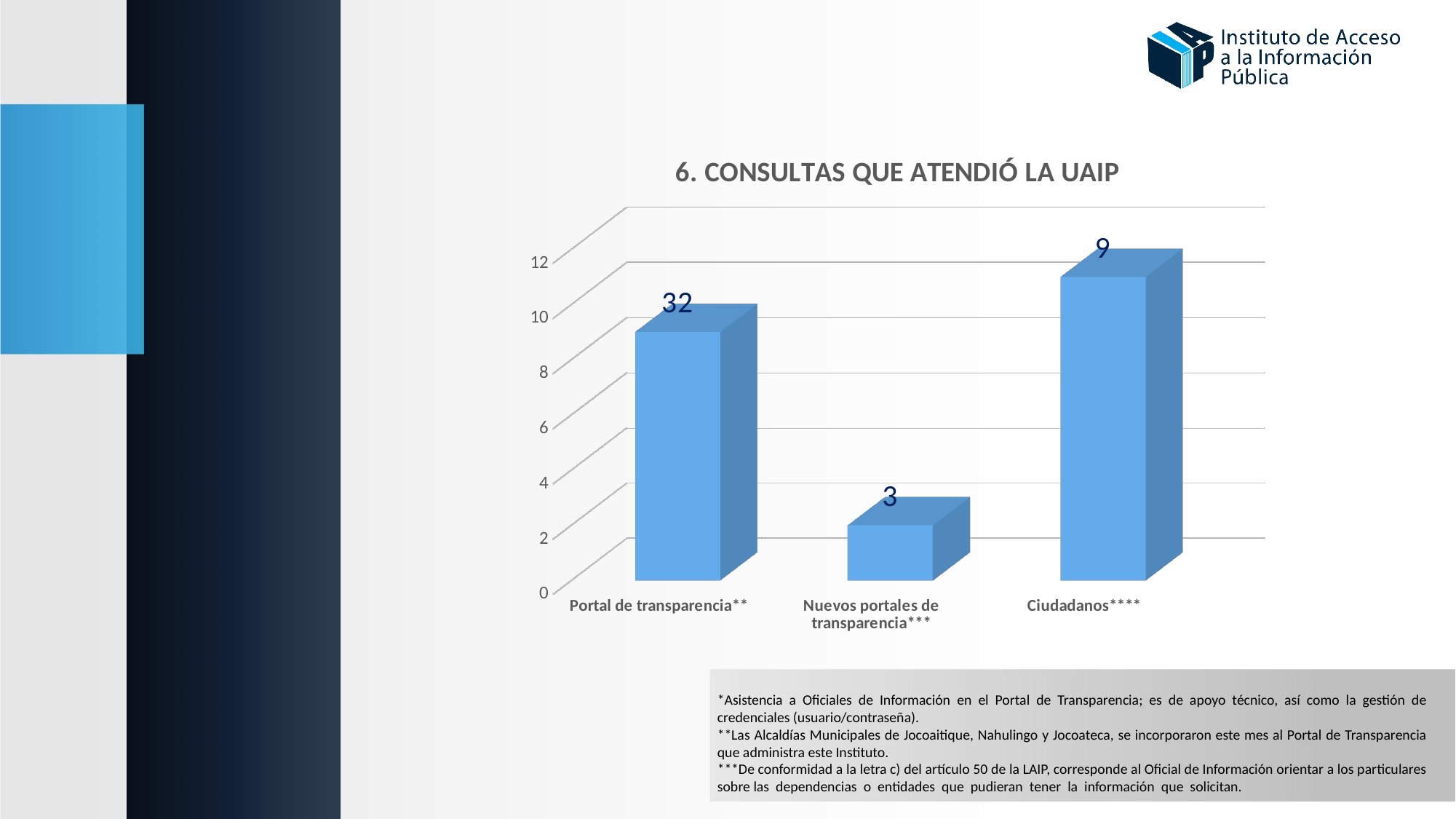
Which is larger, the value for Ciudadanos**** or the value for Nuevos portales de transparencia***? Ciudadanos**** What kind of chart is shown on the slide? Bar chart What is the title of the chart? 6. CONSULTAS QUE ATENDIÓ LA UAIP Which category has the lowest value? Nuevos portales de transparencia*** How many categories are shown in the chart? 3 What is the value for Portal de transparencia**? 32 What is the value for Nuevos portales de transparencia***? 3 What colour are the bars in the chart? Blue What is the value for Ciudadanos****? 9